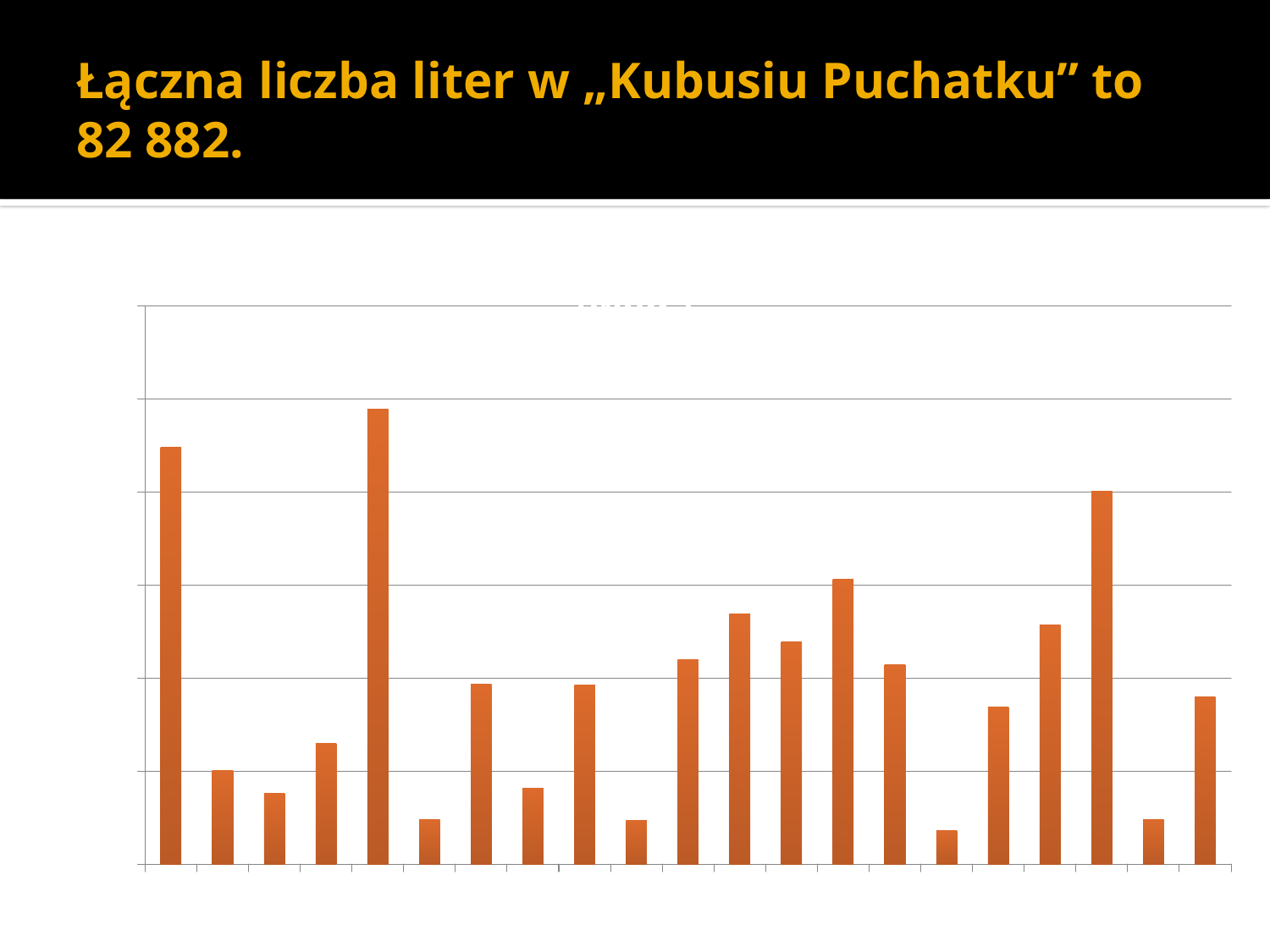
Does the chart display numeric value labels on its vertical axis? No How many bars are plotted in the chart? 21 Which is taller, the 13th bar from the left or the 14th bar from the left? the 14th bar Which is taller, the 19th bar from the left or the last bar on the right? the 19th bar Which is taller, the 4th bar from the left or the 6th bar from the left? the 4th bar What colour are the bars in the chart? orange Which bar, counted from the left, is the tallest in the chart? the 5th bar What kind of chart is shown on the slide? bar chart